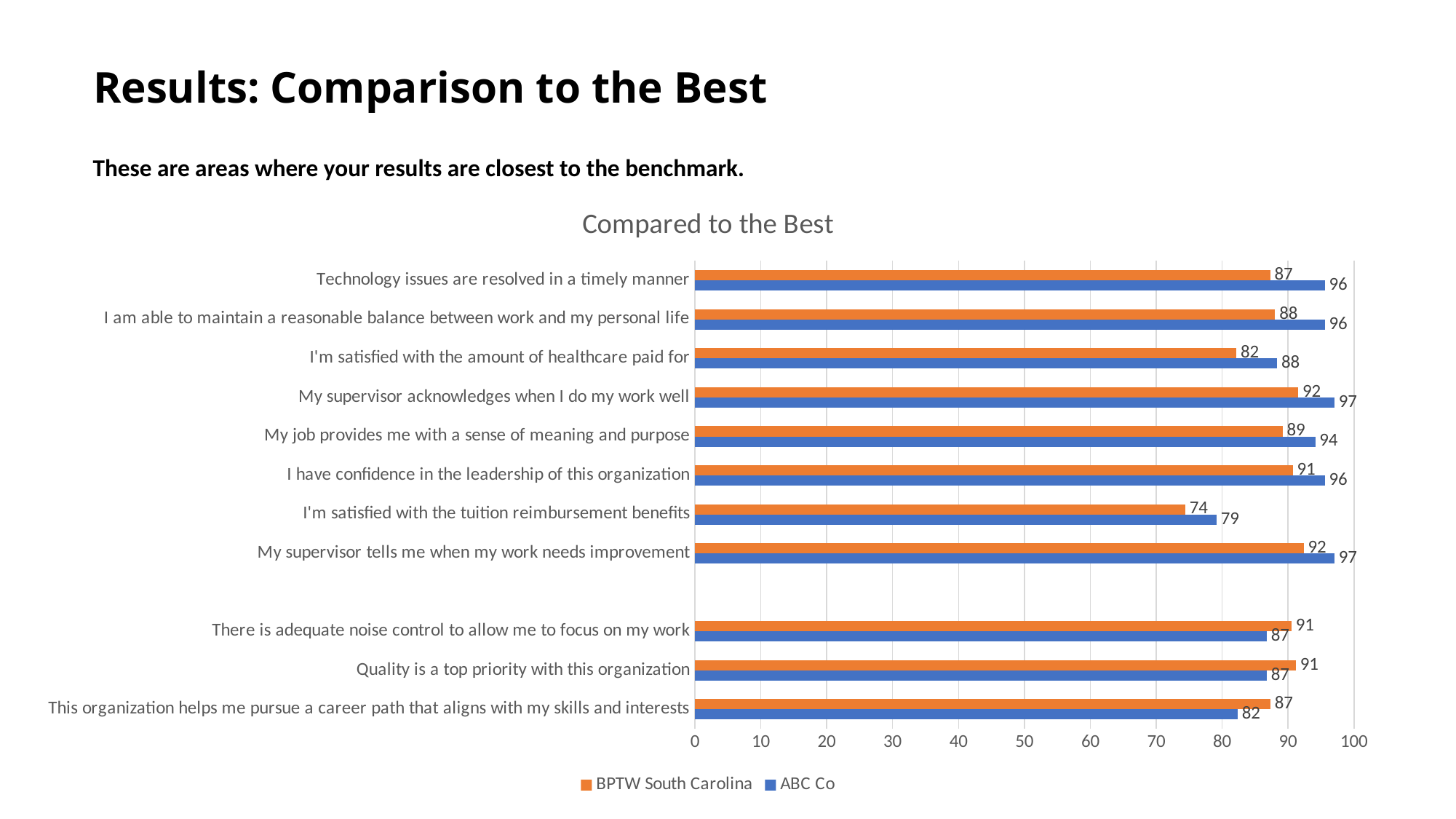
What is the difference between the ABC Co and BPTW South Carolina values for "My supervisor acknowledges when I do my work well"? 5 What kind of chart is shown on the slide? Bar chart What is the BPTW South Carolina value for "My job provides me with a sense of meaning and purpose"? 89 What is the ABC Co value for "I'm satisfied with the amount of healthcare paid for"? 88 How many series does the legend list? 2 For "I have confidence in the leadership of this organization", which series has the larger value, BPTW South Carolina or ABC Co? ABC Co For "Quality is a top priority with this organization", which series has the larger value, BPTW South Carolina or ABC Co? BPTW South Carolina Which category has the lowest ABC Co value? I'm satisfied with the tuition reimbursement benefits What is the BPTW South Carolina value for "I'm satisfied with the tuition reimbursement benefits"? 74 What is the ABC Co value for "Technology issues are resolved in a timely manner"? 96 What is the difference between the BPTW South Carolina and ABC Co values for "This organization helps me pursue a career path that aligns with my skills and interests"? 5 What is the title of the chart? Compared to the Best